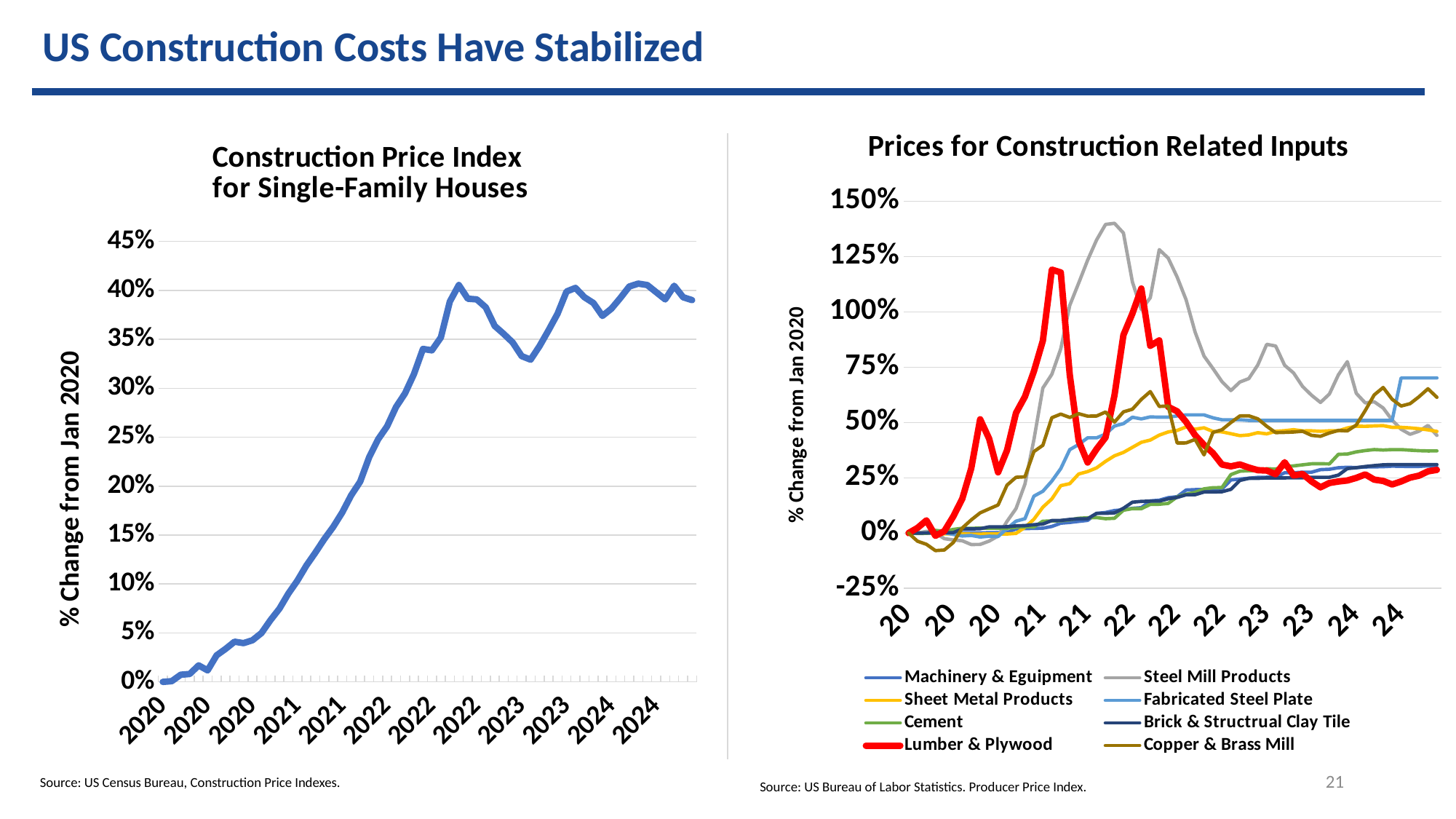
In the 'Construction Price Index for Single-Family Houses' chart, is the value at the end of 2024 greater or less than 35%? greater In the 'Prices for Construction Related Inputs' chart, is the value for Lumber & Plywood at the end of 2024 greater or less than 50%? less What kind of chart is the 'Prices for Construction Related Inputs' chart on the right? line chart What kind of chart is the 'Construction Price Index for Single-Family Houses' chart on the left? line chart In the 'Prices for Construction Related Inputs' chart, what colour is the Lumber & Plywood line? red In the 'Prices for Construction Related Inputs' chart, is the value for Copper & Brass Mill at the end of 2024 greater or less than 50%? greater In the 'Construction Price Index for Single-Family Houses' chart, does the line overall rise or fall from 2020 to 2024? rise In the 'Prices for Construction Related Inputs' chart, how many series does the legend list? 8 In the 'Prices for Construction Related Inputs' chart, at the end of 2024, which is larger: Copper & Brass Mill or Brick & Structrual Clay Tile? Copper & Brass Mill In the 'Prices for Construction Related Inputs' chart, which series reaches the highest peak? Steel Mill Products